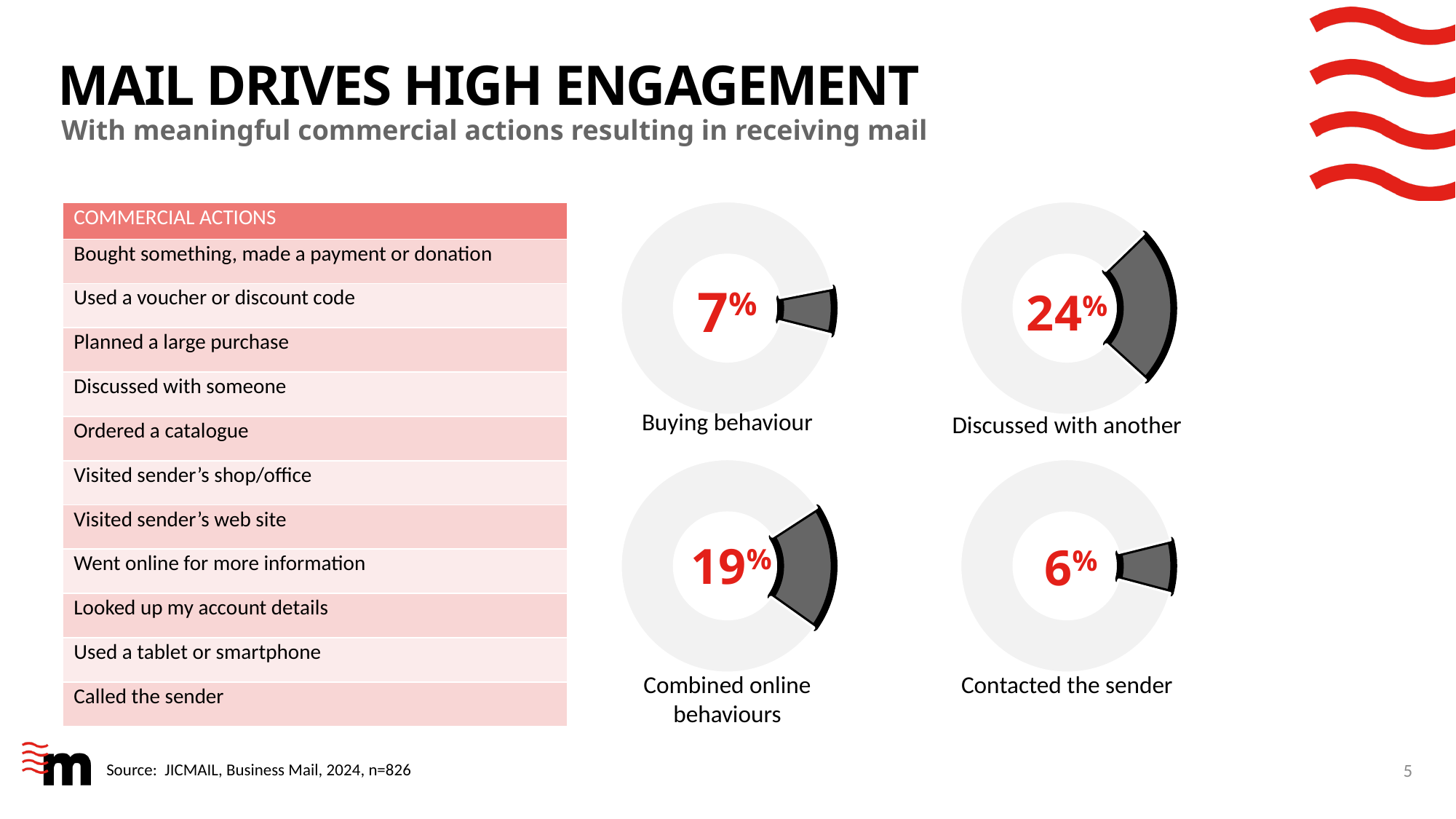
What value is shown on the 'Buying behaviour' donut chart? 7% What value is shown on the 'Combined online behaviours' donut chart? 19% Which of the four donut charts shows the highest percentage? Discussed with another What value is shown on the 'Discussed with another' donut chart? 24% What value is shown on the 'Contacted the sender' donut chart? 6% What kind of chart is used to display the four percentages on the slide? Donut chart What is the header of the table on the left side of the slide? COMMERCIAL ACTIONS How many donut charts are shown on the slide? 4 Which is larger, the 'Combined online behaviours' value or the 'Buying behaviour' value? Combined online behaviours Which of the four donut charts shows the lowest percentage? Contacted the sender What is the difference between the 'Discussed with another' value and the 'Combined online behaviours' value? 5% What is the difference between the 'Buying behaviour' value and the 'Contacted the sender' value? 1%